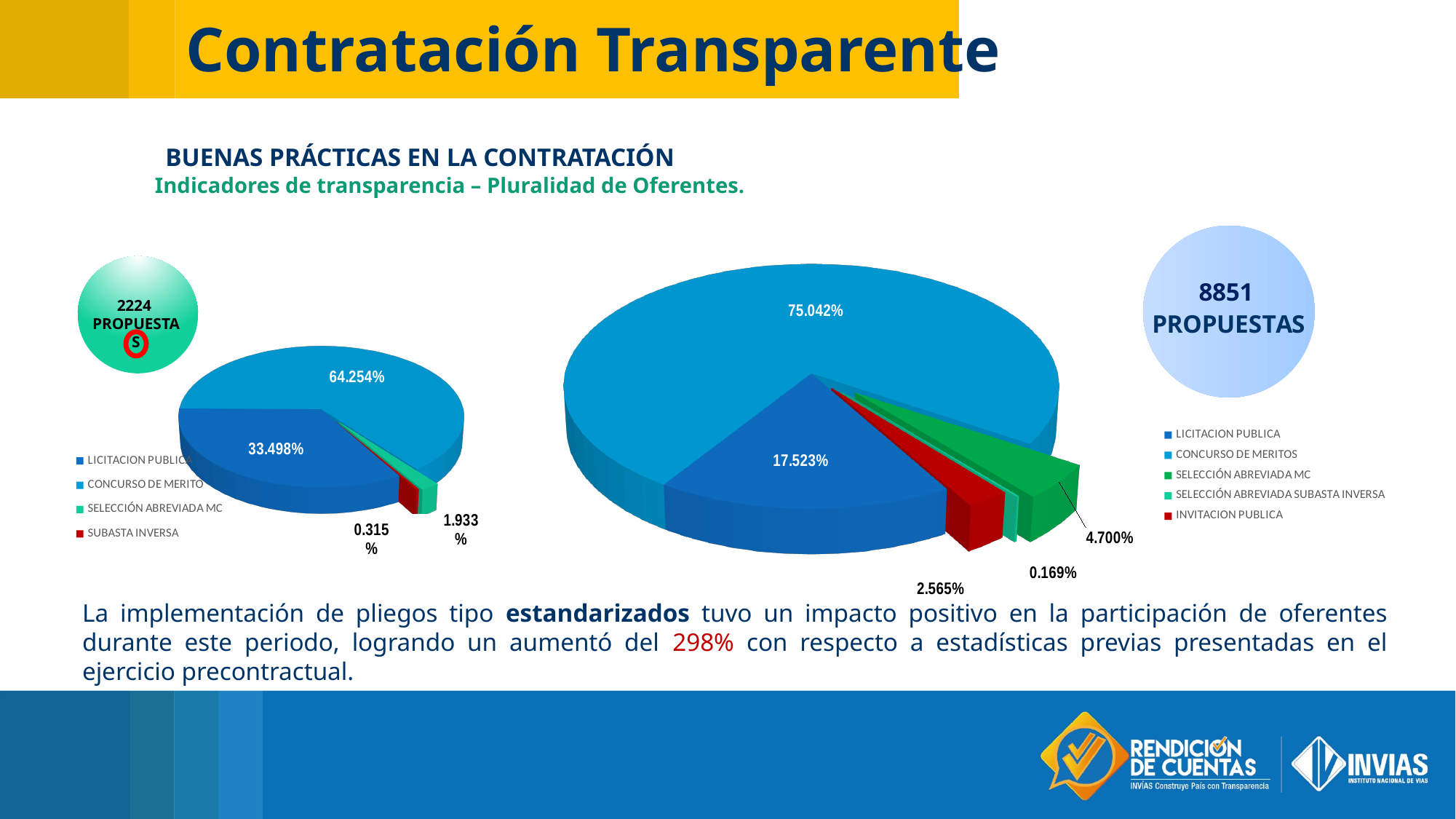
In the left pie chart, which category has the largest share? CONCURSO DE MERITO In the right pie chart, what is the share for LICITACION PUBLICA? 17.523% What type of charts are shown on the slide? Pie charts In the right pie chart, which category has the smallest share? SELECCIÓN ABREVIADA SUBASTA INVERSA How many categories does the legend of the right pie chart list? 5 In the left pie chart, what is the share for SUBASTA INVERSA? 0.315% In the left pie chart, what is the share for CONCURSO DE MERITO? 64.254% How many categories does the legend of the left pie chart list? 4 In the right pie chart, what is the share for CONCURSO DE MERITOS? 75.042% In the left pie chart, what is the share for LICITACION PUBLICA? 33.498% In the right pie chart, what is the difference between the shares of CONCURSO DE MERITOS and LICITACION PUBLICA? 57.519% In the right pie chart, what is the share for SELECCIÓN ABREVIADA MC? 4.700%